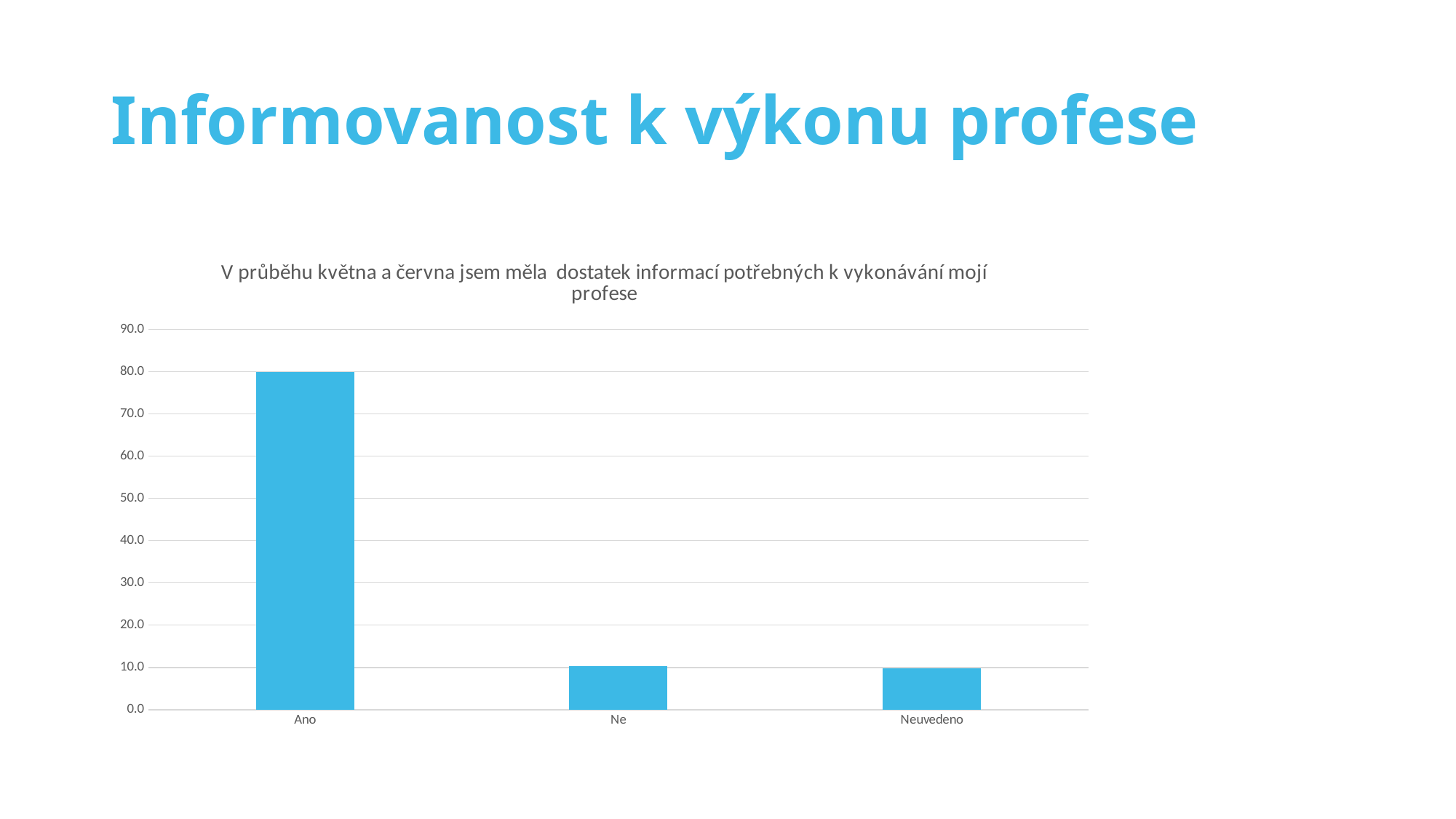
How many categories are shown on the x axis of the chart? 3 Is the value for Neuvedeno greater or less than 20.0? less Is the value for Ne greater or less than 20.0? less Which category has the highest value in the chart? Ano Is the value for Ano greater or less than 70.0? greater Which is larger, the value for Ano or the value for Neuvedeno? Ano What is the highest value shown on the y axis of the chart? 90.0 What kind of chart is shown on the slide? bar chart Which is larger, the value for Ano or the value for Ne? Ano What is the label of the first category on the x axis of the chart? Ano